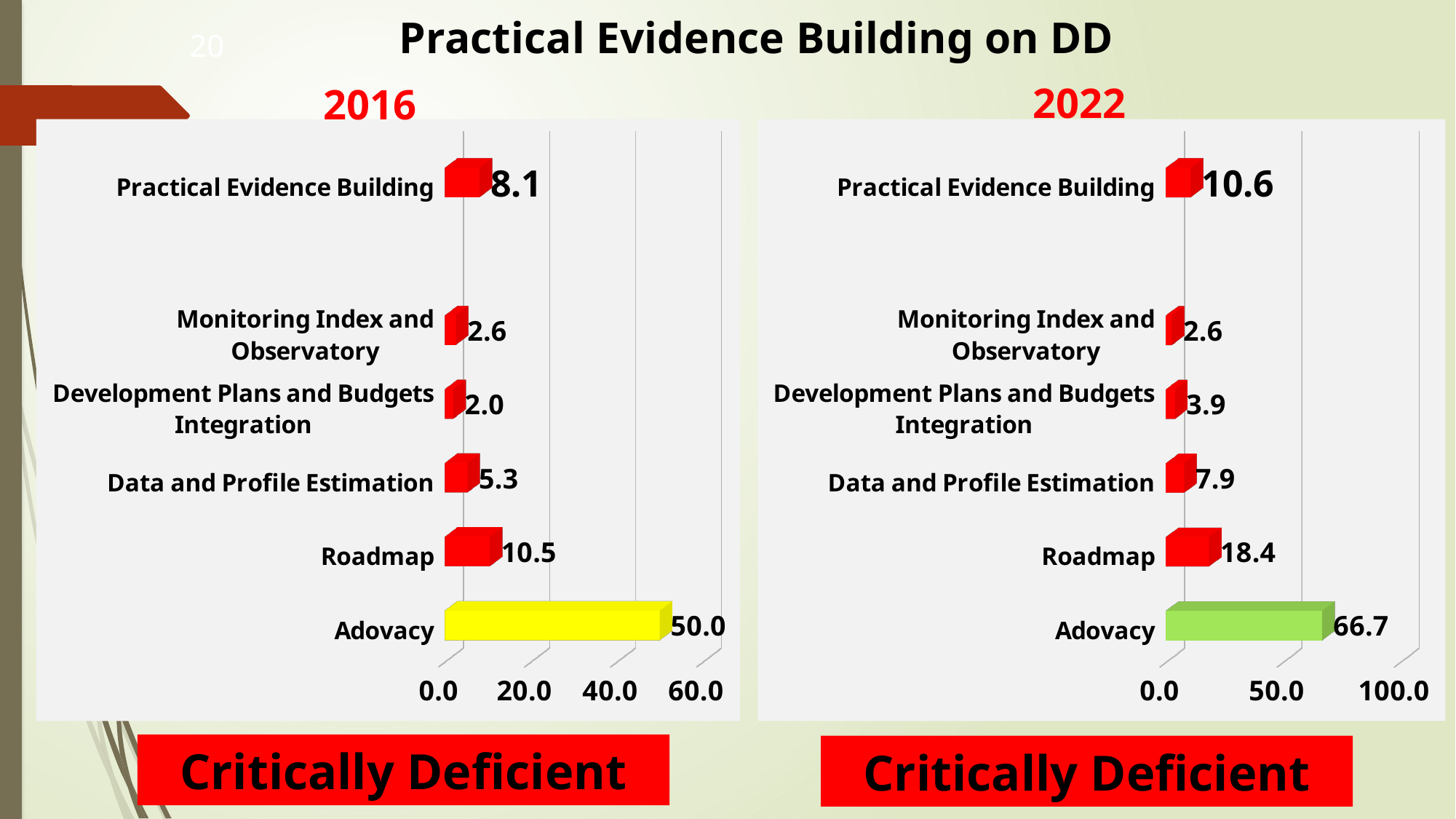
How many categories are shown in the 2022 chart? 6 In the 2022 chart, what is the value for Roadmap? 18.4 In the 2022 chart, what is the value for Practical Evidence Building? 10.6 In the 2016 chart, which category has the lowest value? Development Plans and Budgets Integration What colour is the Adovacy bar in the 2016 chart? Yellow What kind of chart is the 2016 chart? Bar chart In the 2016 chart, what is the value for Adovacy? 50.0 In the 2022 chart, what is the difference between Adovacy and Roadmap? 48.3 In the 2022 chart, is the value for Adovacy greater or less than 50.0? greater In the 2016 chart, what is the difference between Roadmap and Practical Evidence Building? 2.4 In the 2022 chart, which category has the highest value? Adovacy In the 2016 chart, which is larger: Data and Profile Estimation or Monitoring Index and Observatory? Data and Profile Estimation